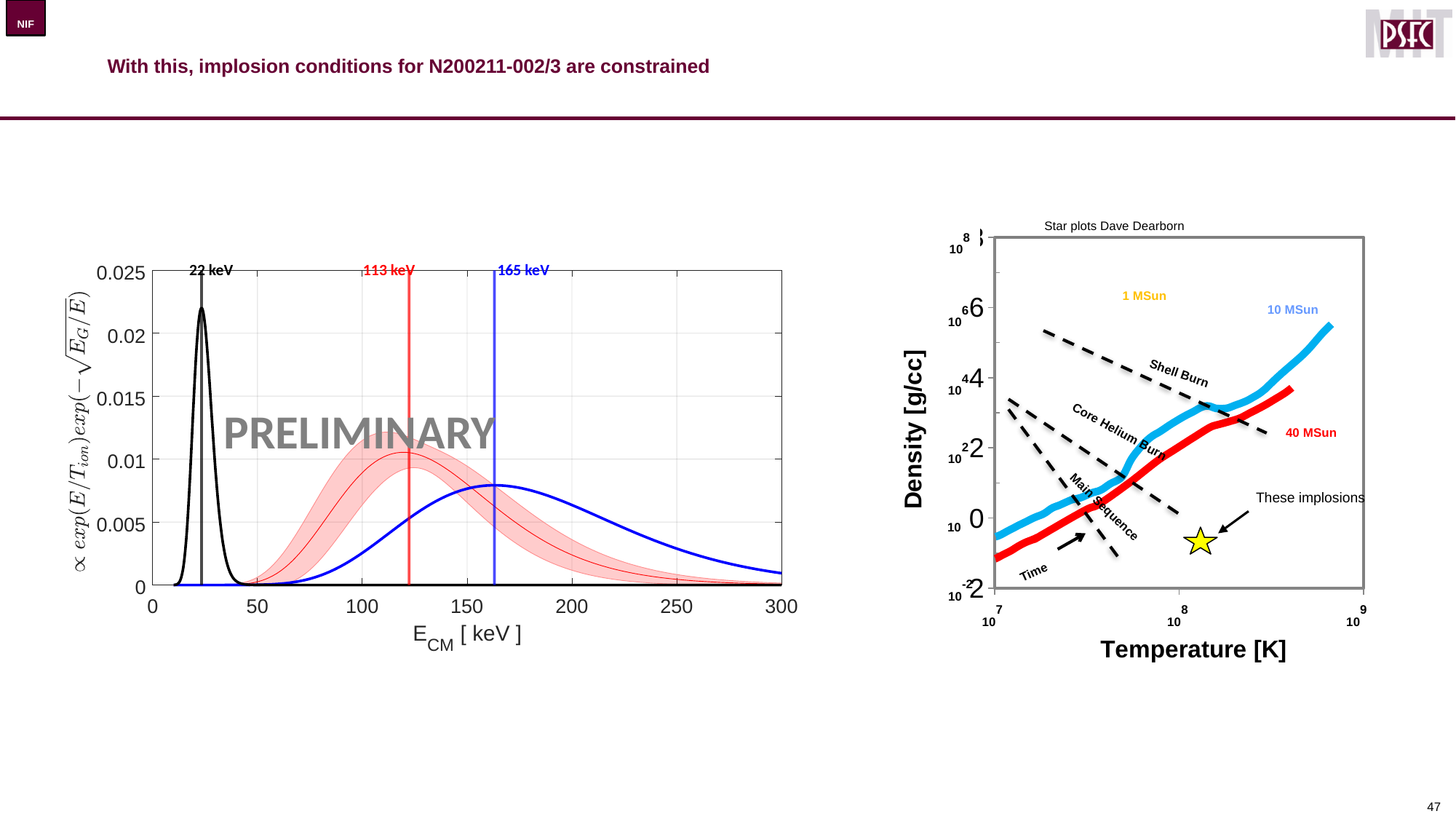
What kind of chart is the left chart? line chart On the left chart, what energy value labels the blue vertical line? 165 keV On the right chart, what is the x-axis label? Temperature [K] On the left chart, what energy value labels the red vertical line? 113 keV On the left chart, what energy value labels the black vertical line? 22 keV On the left chart, what is the largest value shown on the x axis? 300 On the left chart, is the peak of the blue curve greater or less than 0.01? less On the left chart, what is the difference between the energies labeled on the blue and black vertical lines? 143 keV On the right chart, what label is attached to the red curve? 40 MSun On the left chart, is the peak of the black curve greater or less than 0.02? greater On the left chart, which curve has the lowest peak: the black, red or blue one? blue On the left chart, which curve reaches the highest peak: the black, red or blue one? black